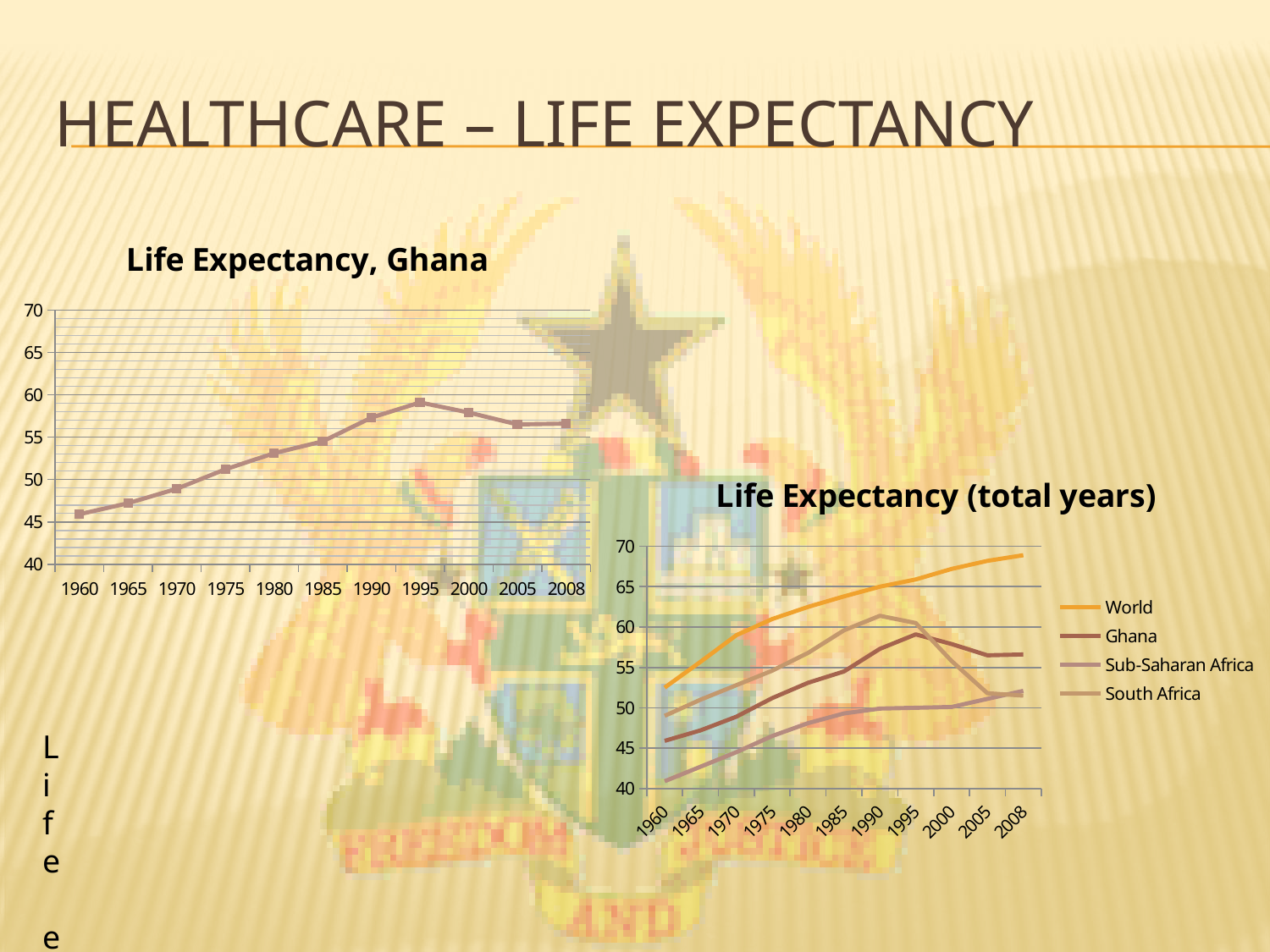
In the 'Life Expectancy, Ghana' chart, which year has the lowest life expectancy? 1960 In the 'Life Expectancy, Ghana' chart, is the value for 1995 greater or less than 55? greater In the 'Life Expectancy, Ghana' chart, does life expectancy rise or fall between 1960 and 1995? rise In the 'Life Expectancy (total years)' chart, is the World value for 2008 greater or less than 65? greater In the 'Life Expectancy, Ghana' chart, is the value for 1960 greater or less than 50? less How many series does the legend of the 'Life Expectancy (total years)' chart list? 4 In the 'Life Expectancy (total years)' chart, which series has the highest value in 2008? World What kind of chart is the 'Life Expectancy, Ghana' chart? line chart In the 'Life Expectancy, Ghana' chart, which year has the highest life expectancy? 1995 In the 'Life Expectancy, Ghana' chart, how many years are shown on the x axis? 11 In the 'Life Expectancy (total years)' chart, which series has the lowest value in 1960? Sub-Saharan Africa